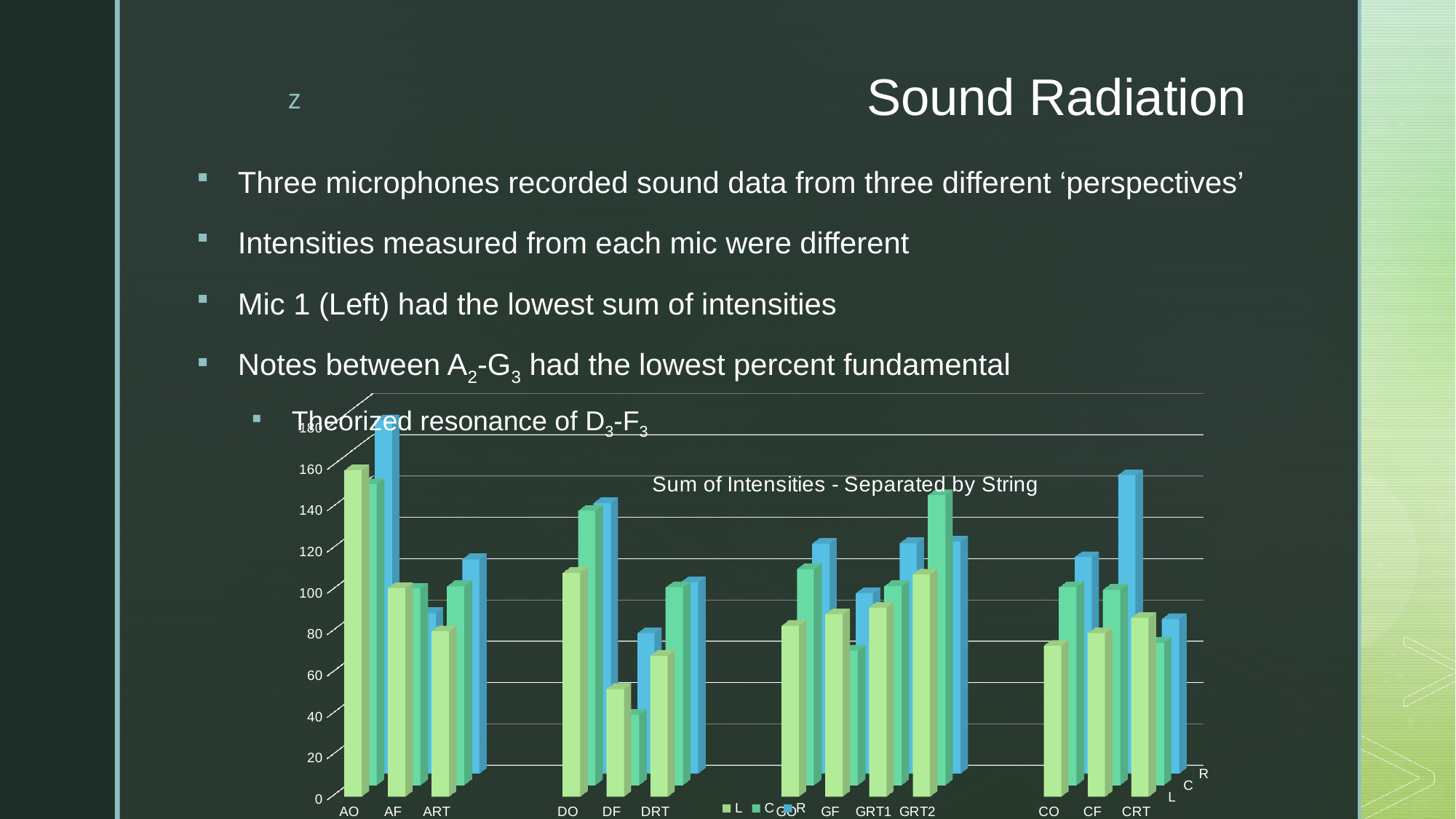
Is the value of the L series for CO greater or less than 80? less What type of chart is shown on the slide? bar chart Which category has the tallest bar in the chart? AO Which is larger: the R series value for AO or the C series value for DF? AO Is the value of the C series for DF greater or less than 60? less Is the value of the R series for AO greater or less than 160? greater How many series does the chart legend list? 3 What is the title of the chart? Sum of Intensities - Separated by String How many categories are shown along the x axis of the chart? 13 What are the series names listed in the chart legend? L, C, R